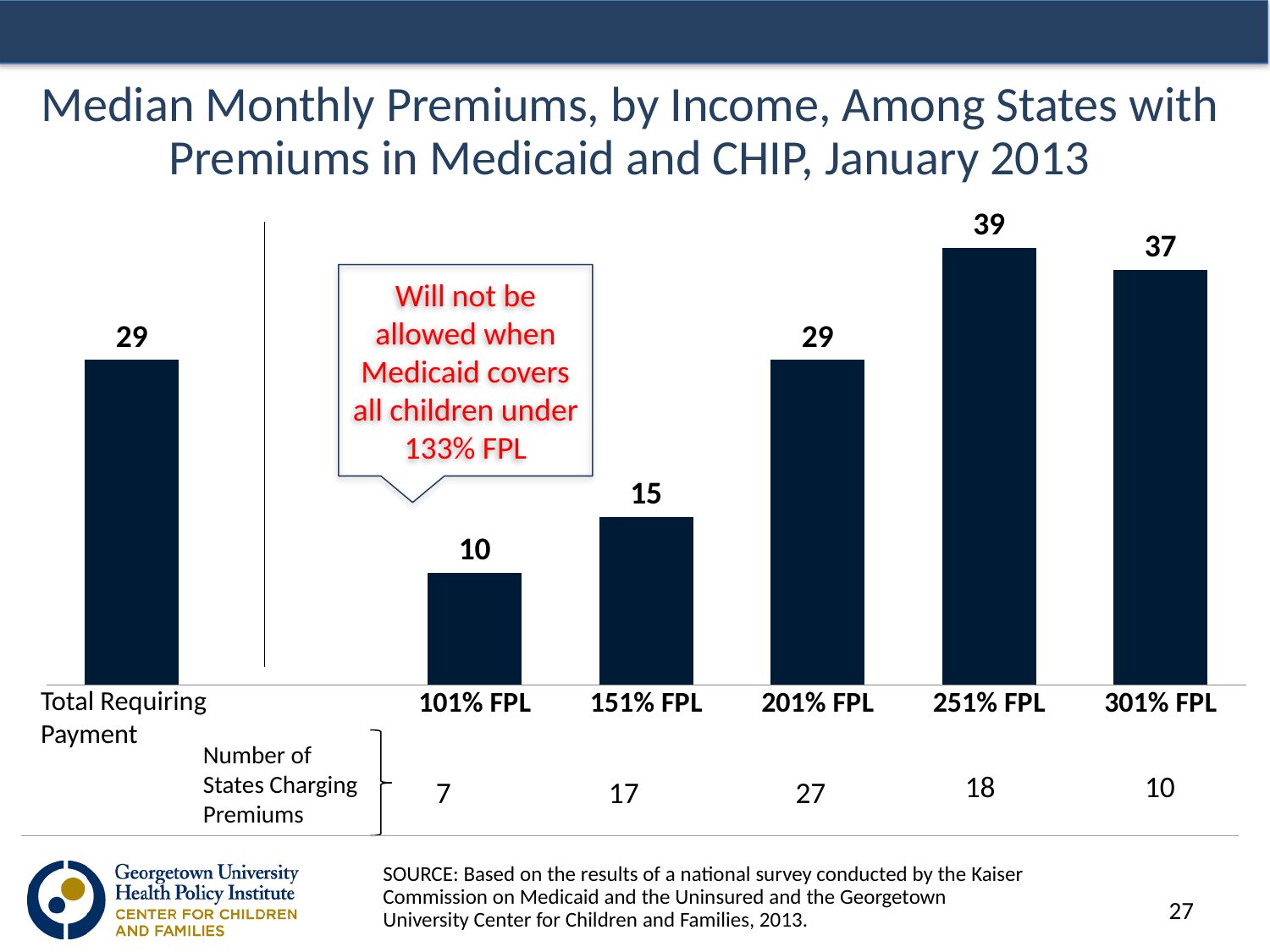
Which income category has the highest median monthly premium? 251% FPL What is the difference between the median monthly premiums for 251% FPL and 301% FPL? 2 What is the difference between the median monthly premiums for 151% FPL and 101% FPL? 5 How many states charge premiums at the 201% FPL level, according to the row below the chart? 27 According to the callout, which bar will not be allowed when Medicaid covers all children under 133% FPL? 101% FPL How many bars are plotted in the chart? 6 What is the median monthly premium for the 251% FPL category? 39 What is the median monthly premium for the 101% FPL category? 10 What is the value of the Total Requiring Payment bar? 29 What kind of chart is shown on the slide? Bar chart Which is larger, the median monthly premium for 201% FPL or for 151% FPL? 201% FPL Which income category has the lowest median monthly premium? 101% FPL